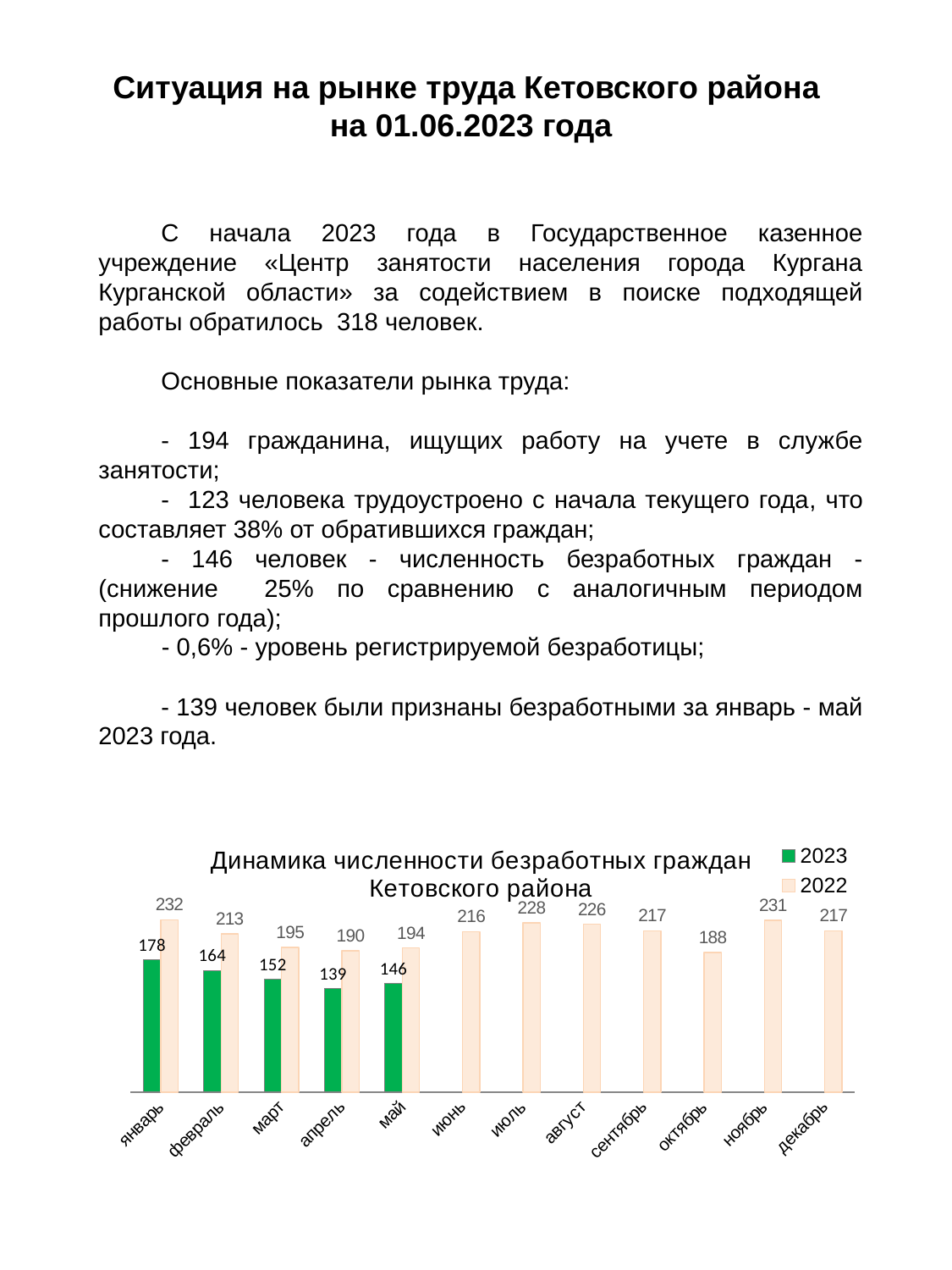
How many series does the legend list? 2 Which is larger: the 2023 value in май or the 2023 value in март? март Which month has the highest value for the 2022 series? январь What is the value for 2023 in апрель? 139 How many months are shown on the x axis? 12 Which month has the lowest value for the 2023 series? апрель What kind of chart is shown? bar chart What is the value for 2022 in ноябрь? 231 Which month has the lowest value for the 2022 series? октябрь Which colour represents the 2023 series? green What is the difference between the 2022 and 2023 values in январь? 54 What is the value for 2022 in октябрь? 188